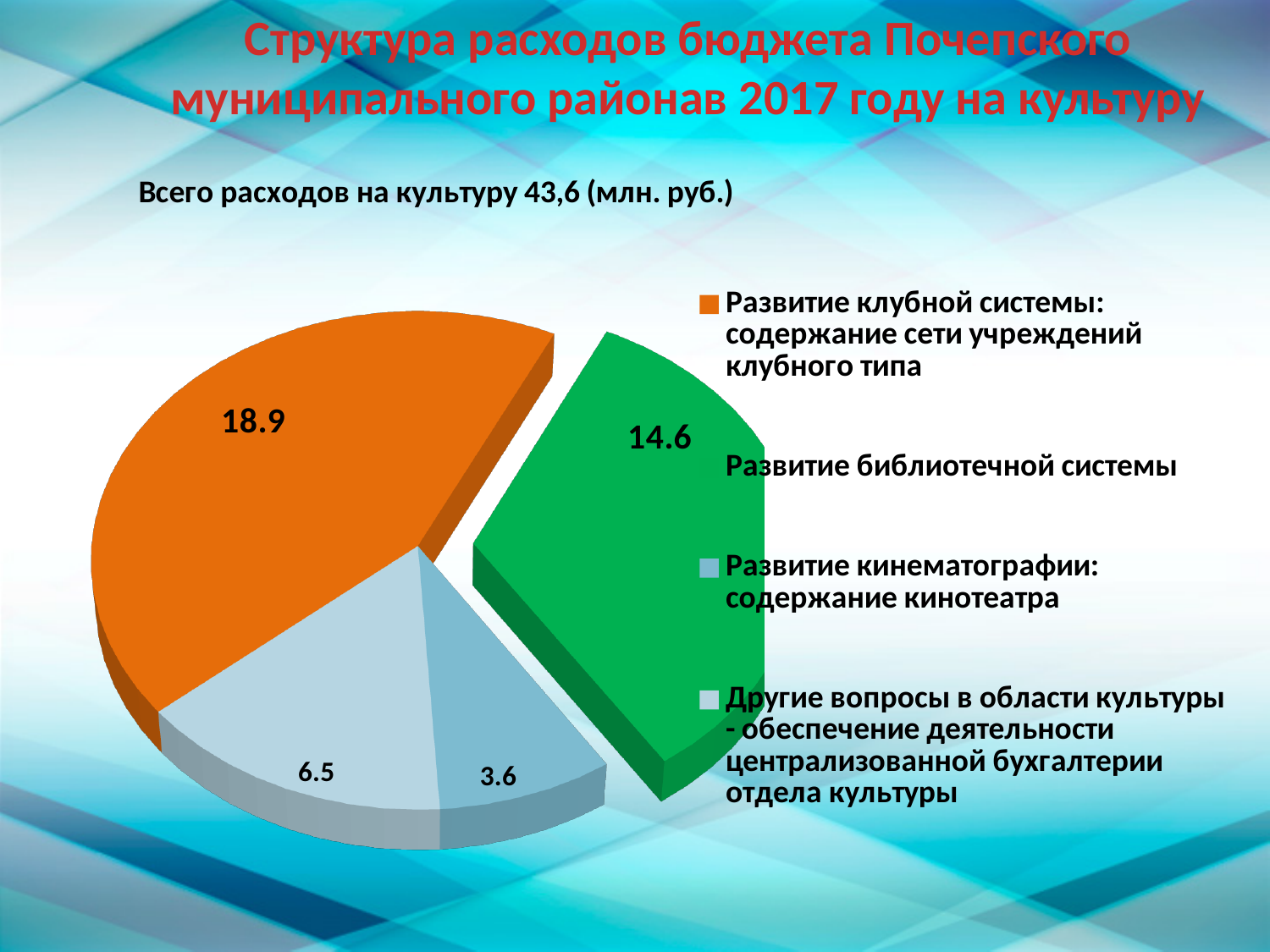
What is the value for "Развитие кинематографии: содержание кинотеатра"? 3.6 What is the value for "Развитие клубной системы: содержание сети учреждений клубного типа"? 18.9 What type of chart is shown on the slide? Pie chart What is the value for "Другие вопросы в области культуры - обеспечение деятельности централизованной бухгалтерии отдела культуры"? 6.5 What total expenditure on culture is stated on the slide? 43,6 (млн. руб.) What colour is the slice for "Развитие клубной системы: содержание сети учреждений клубного типа"? Orange What is the difference between the values for "Развитие клубной системы" and "Развитие библиотечной системы"? 4.3 Which category has the largest slice of the pie? Развитие клубной системы: содержание сети учреждений клубного типа How many slices does the pie chart have? 4 Which is larger: the value for "Развитие кинематографии" or the value for "Другие вопросы в области культуры"? Другие вопросы в области культуры What is the value for "Развитие библиотечной системы"? 14.6 Which category has the smallest slice of the pie? Развитие кинематографии: содержание кинотеатра